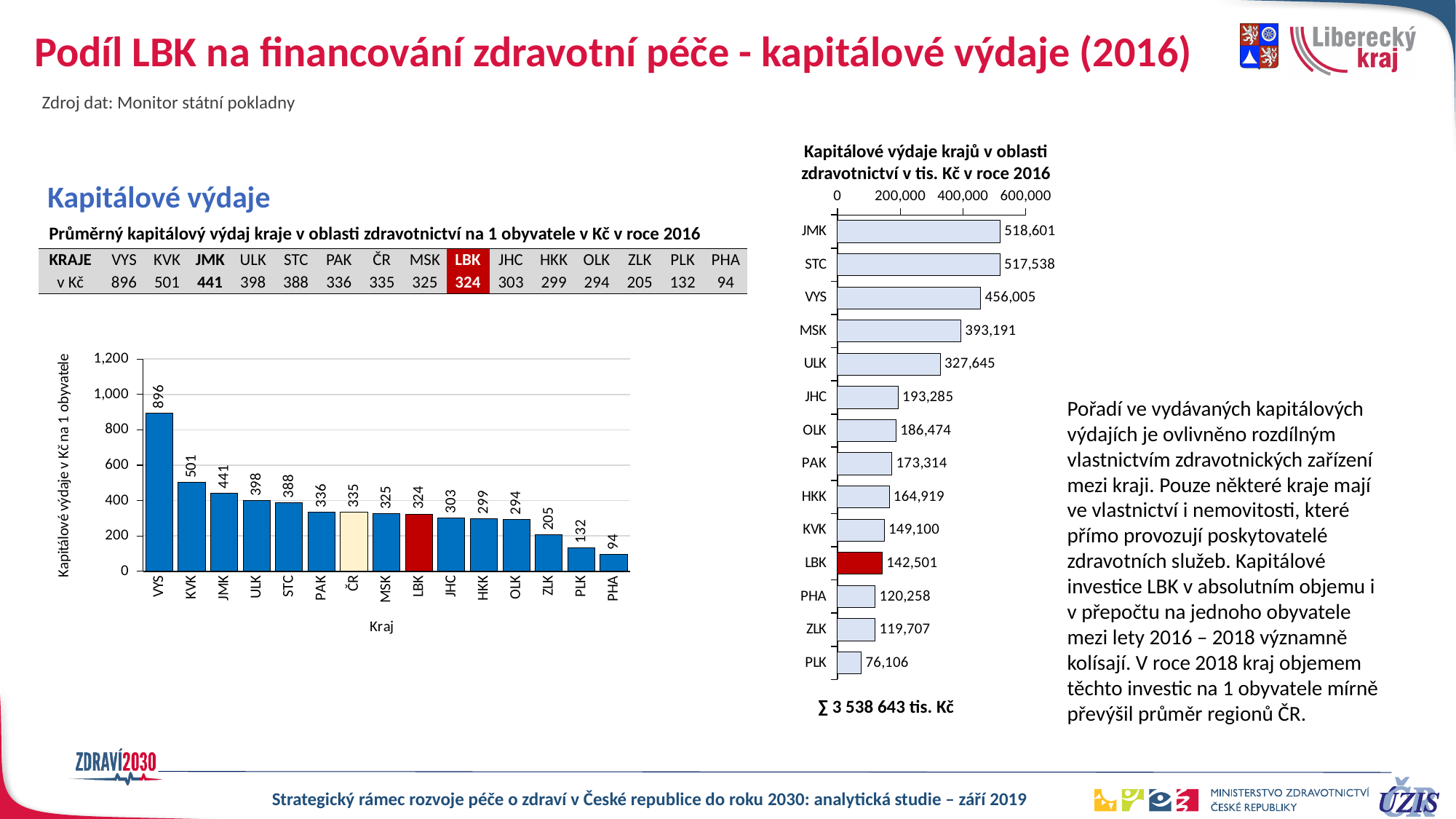
In the left chart (per-capita capital expenditure), how many bars are plotted? 15 In the left chart (per-capita capital expenditure), which region has the lowest value? PHA What type of chart is the left chart (per-capita capital expenditure)? bar chart In the right chart (Kapitálové výdaje krajů v tis. Kč), which region has the lowest value? PLK In the right chart (Kapitálové výdaje krajů v tis. Kč), which region has the highest value? JMK In the right chart (Kapitálové výdaje krajů v oblasti zdravotnictví v tis. Kč v roce 2016), what is the value for LBK? 142,501 In the right chart (Kapitálové výdaje krajů v tis. Kč), how many regions are plotted? 14 In the left chart (Průměrný kapitálový výdaj kraje ... na 1 obyvatele), what is the value for LBK? 324 In the right chart (Kapitálové výdaje krajů v tis. Kč), which is larger: the value for MSK or the value for ULK? MSK In the left chart (per-capita capital expenditure), which region has the highest value? VYS In the right chart (Kapitálové výdaje krajů v tis. Kč), what is the difference between JMK and STC? 1,063 In the left chart (per-capita capital expenditure), what is the difference between VYS and KVK? 395